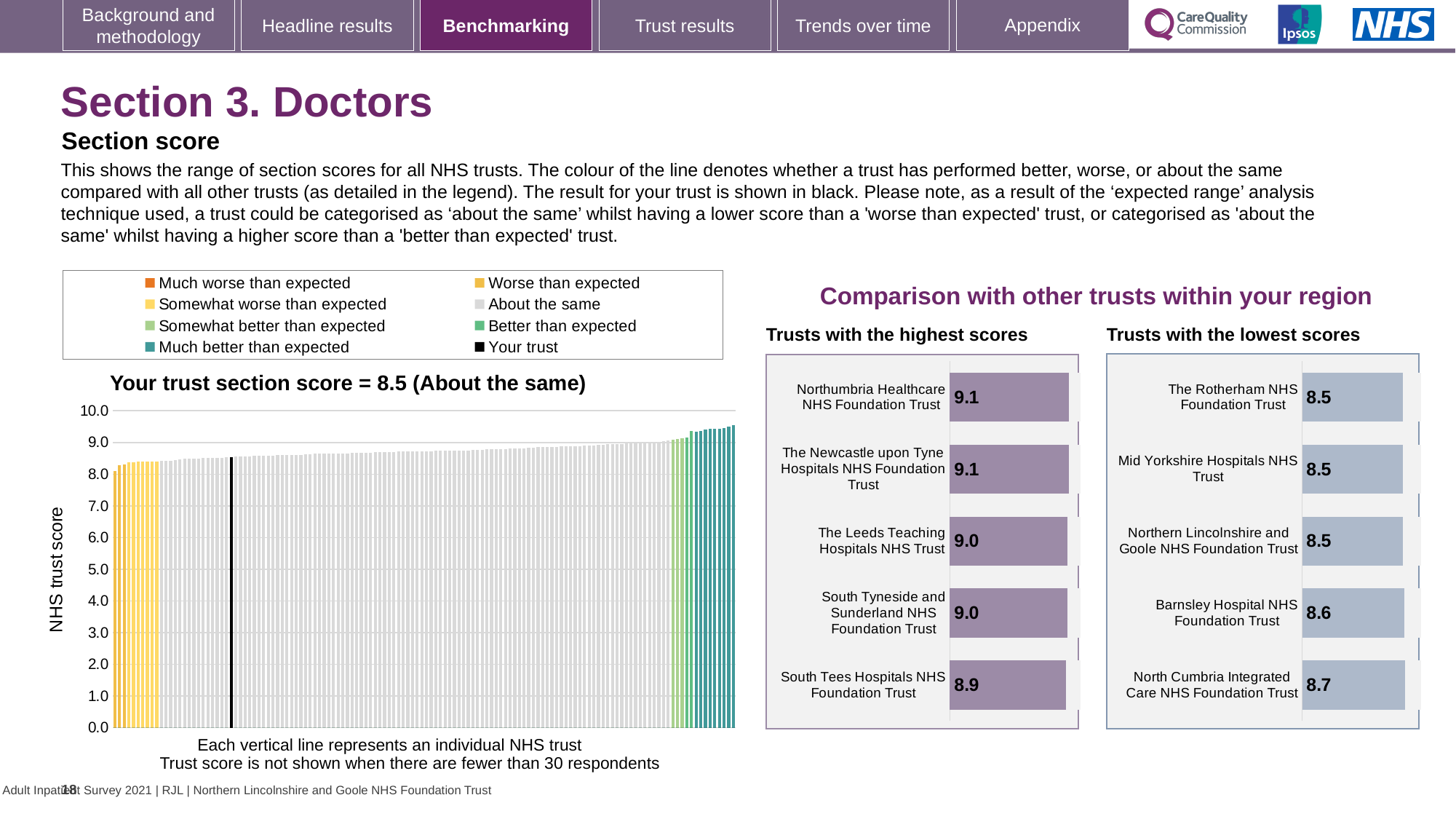
On the 'Trusts with the highest scores' chart, what is the score for South Tees Hospitals NHS Foundation Trust? 8.9 On the 'Trusts with the highest scores' chart, which trust has the lowest score? South Tees Hospitals NHS Foundation Trust What kind of chart is the 'Trusts with the lowest scores' chart? Bar chart On the main chart on the left showing all NHS trusts, what is your trust's section score? 8.5 How many entries does the legend of the main chart on the left list? 8 On the 'Trusts with the lowest scores' chart, which has the larger score: North Cumbria Integrated Care NHS Foundation Trust or The Rotherham NHS Foundation Trust? North Cumbria Integrated Care NHS Foundation Trust On the 'Trusts with the highest scores' chart, what is the difference between the scores of Northumbria Healthcare NHS Foundation Trust and South Tees Hospitals NHS Foundation Trust? 0.2 On the 'Trusts with the lowest scores' chart, which trust has the highest score? North Cumbria Integrated Care NHS Foundation Trust On the 'Trusts with the lowest scores' chart, what is the score for Barnsley Hospital NHS Foundation Trust? 8.6 On the 'Trusts with the highest scores' chart, how many trusts are shown? 5 On the 'Trusts with the highest scores' chart, what is the score for Northumbria Healthcare NHS Foundation Trust? 9.1 On the 'Trusts with the lowest scores' chart, what is the difference between the scores of North Cumbria Integrated Care NHS Foundation Trust and Barnsley Hospital NHS Foundation Trust? 0.1